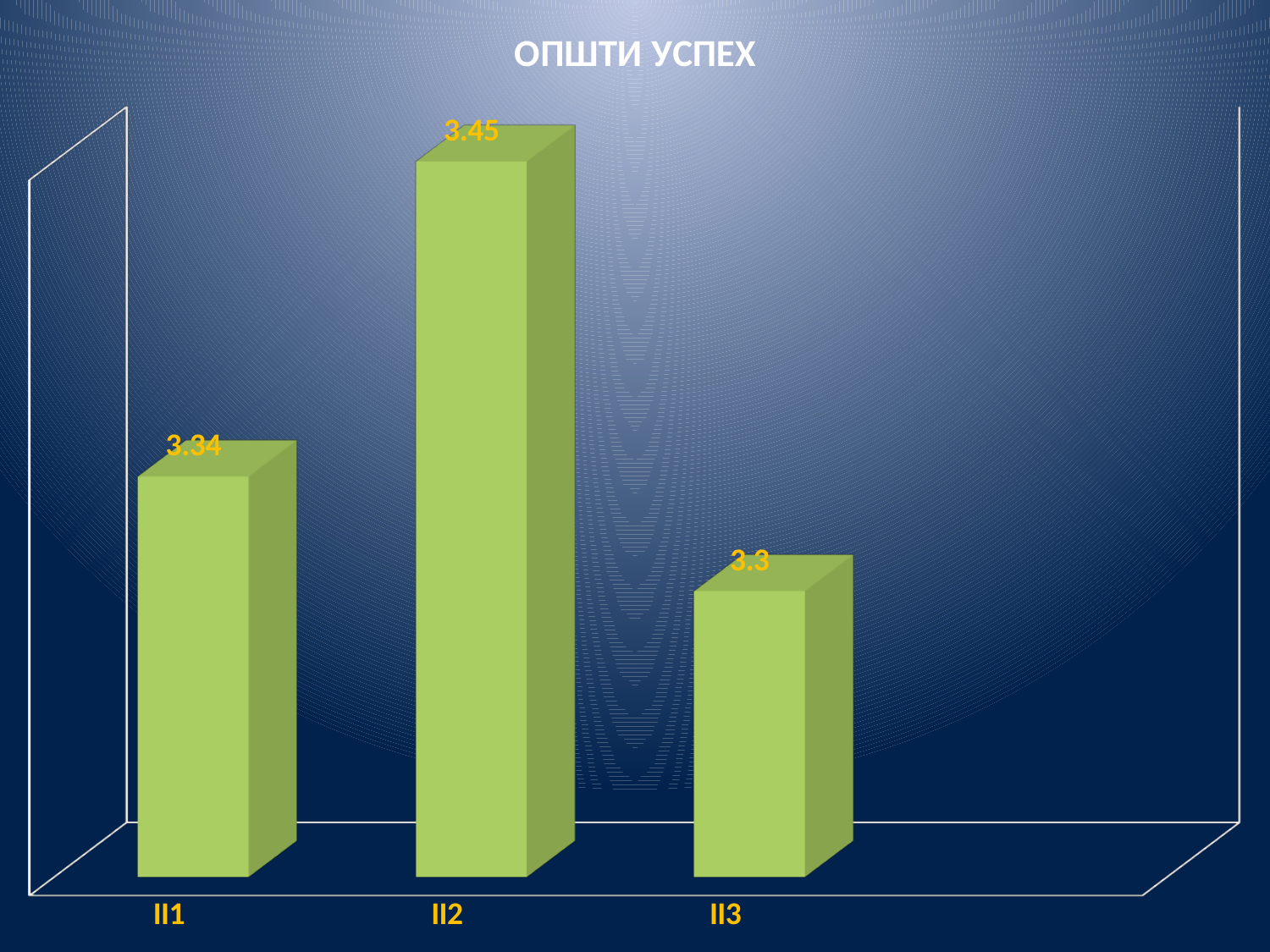
Which category has the highest value? II2 Which category has the lowest value? II3 What is the value for II3? 3.3 What is the difference between the values for II2 and II1? 0.11 What is the title of the chart? ОПШТИ УСПЕХ What colour are the bars in the chart? green What is the difference between the values for II1 and II3? 0.04 What kind of chart is shown on the slide? bar chart Which is larger, the value for II2 or the value for II3? II2 What is the value for II2? 3.45 What is the value for II1? 3.34 How many categories are shown in the chart? 3